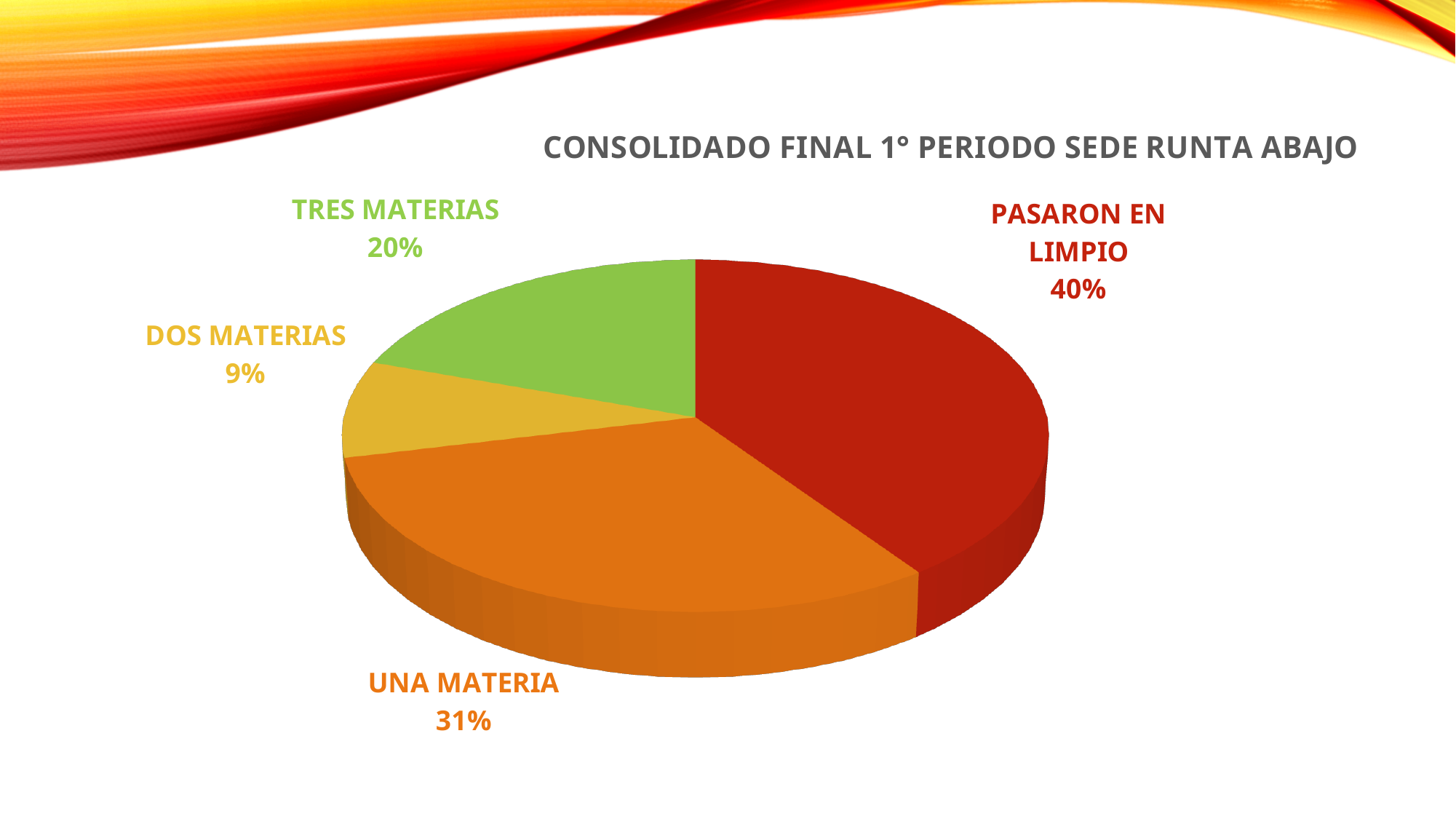
Which category has the largest share of the pie? PASARON EN LIMPIO What is the difference in percentage points between PASARON EN LIMPIO and UNA MATERIA? 9 What percentage of the pie is labelled DOS MATERIAS? 9% What percentage of the pie is labelled UNA MATERIA? 31% What kind of chart is shown on the slide? Pie chart What percentage of the pie is labelled PASARON EN LIMPIO? 40% Which category has the smallest share of the pie? DOS MATERIAS Which is larger, the share for TRES MATERIAS or the share for DOS MATERIAS? TRES MATERIAS What is the title of the chart? CONSOLIDADO FINAL 1° PERIODO SEDE RUNTA ABAJO What colour is the slice for TRES MATERIAS? Green What percentage of the pie is labelled TRES MATERIAS? 20% How many slices does the pie chart have? 4